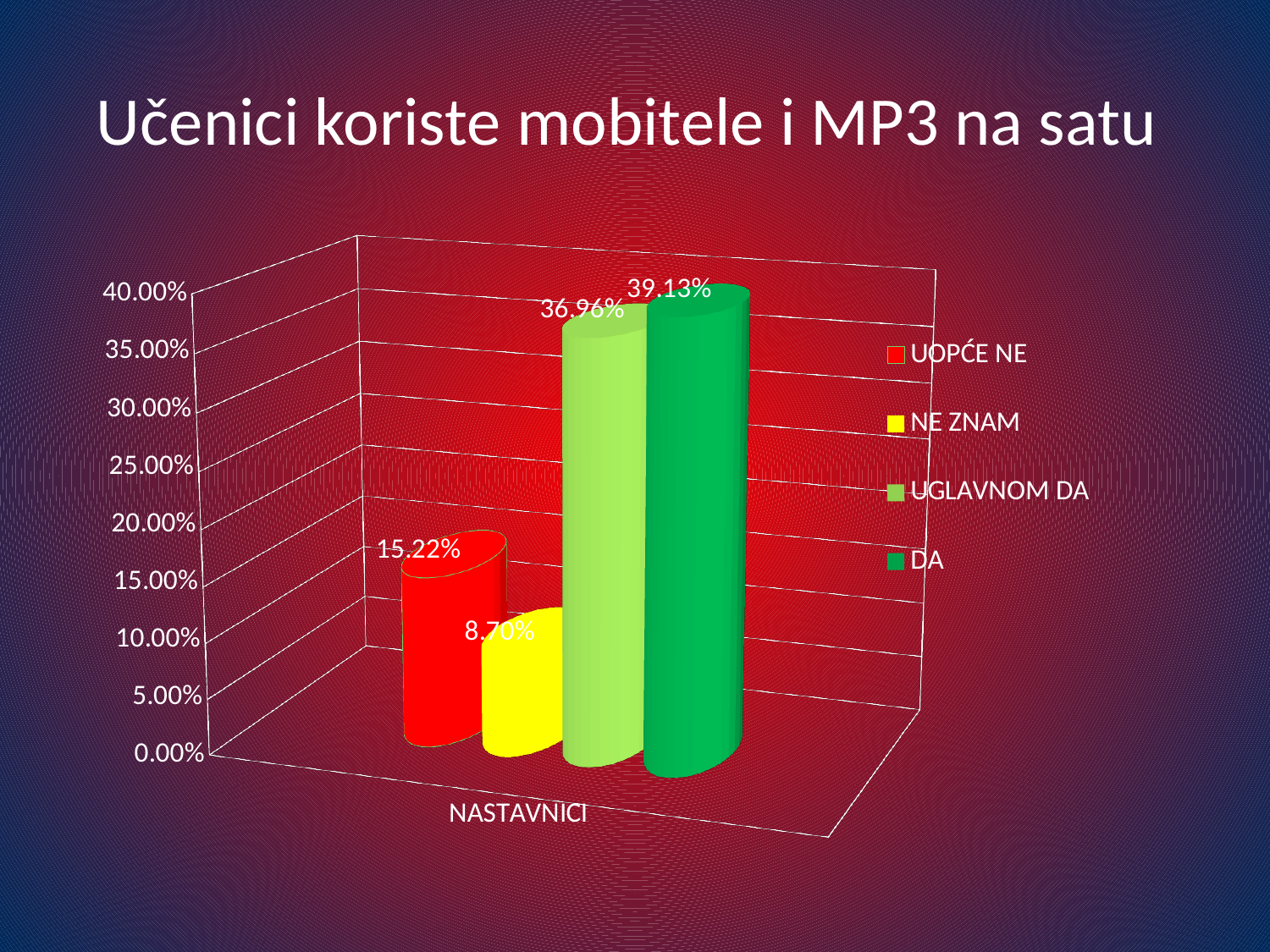
Which series has the lowest value? NE ZNAM What is the category label shown on the x axis? NASTAVNICI What is the difference between the values for UOPĆE NE and NE ZNAM? 6.52% What is the value for NE ZNAM? 8.70% How many series does the legend list? 4 What is the value for UGLAVNOM DA? 36.96% Which is larger, the value for UOPĆE NE or the value for NE ZNAM? UOPĆE NE What is the value for UOPĆE NE? 15.22% Which series has the highest value? DA What kind of chart is shown on the slide? bar chart What is the value for DA? 39.13% What is the difference between the values for DA and UGLAVNOM DA? 2.17%